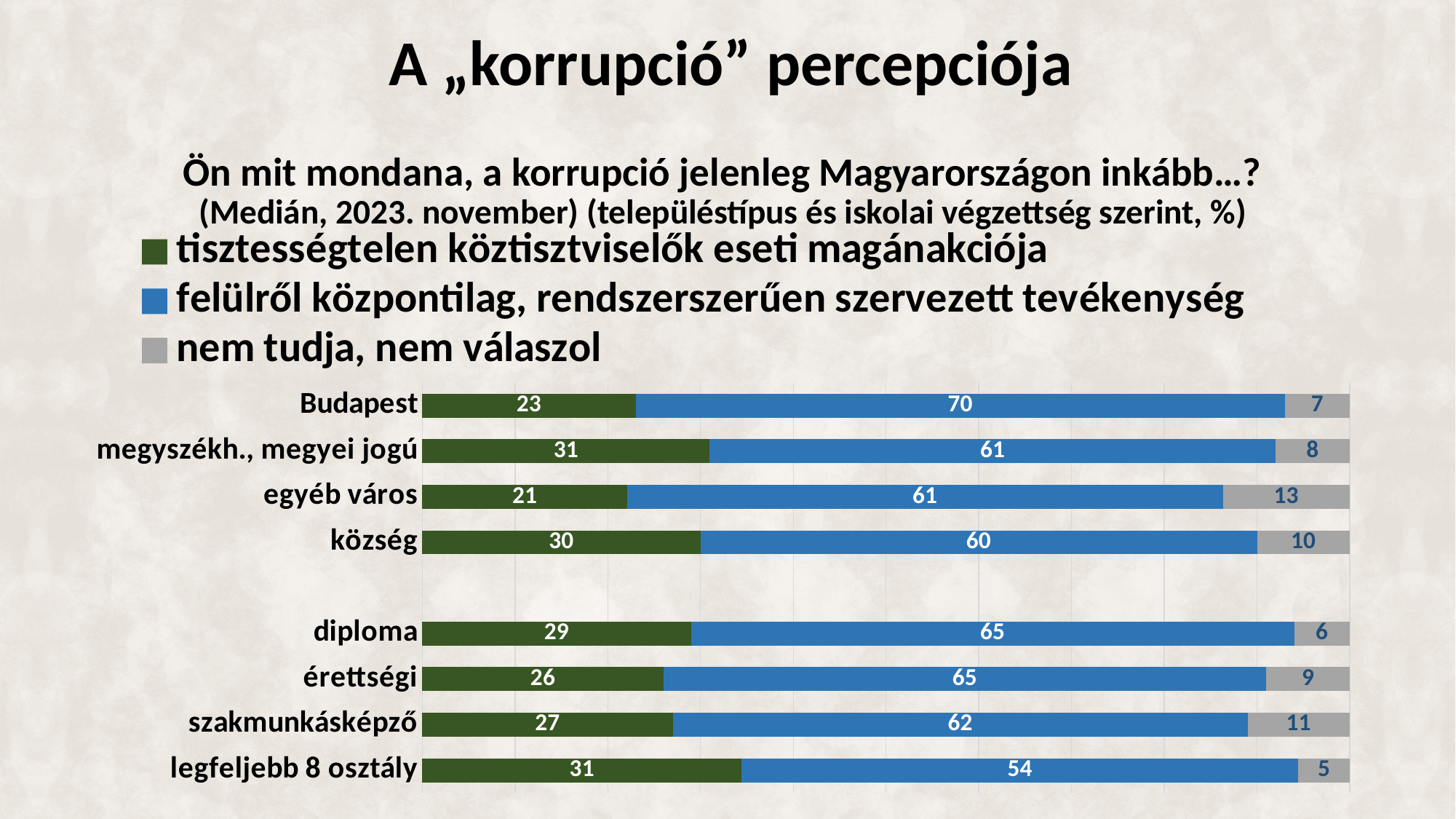
What is the total of the stacked bar for egyéb város? 95 What is the value for legfeljebb 8 osztály in the "tisztességtelen köztisztviselők eseti magánakciója" series? 31 What is the value for egyéb város in the "nem tudja, nem válaszol" series? 13 What is the difference between the "felülről központilag, rendszerszerűen szervezett tevékenység" values for Budapest and legfeljebb 8 osztály? 16 What is the value for Budapest in the "felülről központilag, rendszerszerűen szervezett tevékenység" series? 70 Which is larger: the "tisztességtelen köztisztviselők eseti magánakciója" value for község or for érettségi? község Which category has the lowest value in the "nem tudja, nem válaszol" series? legfeljebb 8 osztály What kind of chart is shown on the slide? stacked bar chart How many series does the legend list? 3 How many categories are shown on the chart? 8 Which category has the highest value in the "felülről központilag, rendszerszerűen szervezett tevékenység" series? Budapest Which category has the lowest value in the "tisztességtelen köztisztviselők eseti magánakciója" series? egyéb város